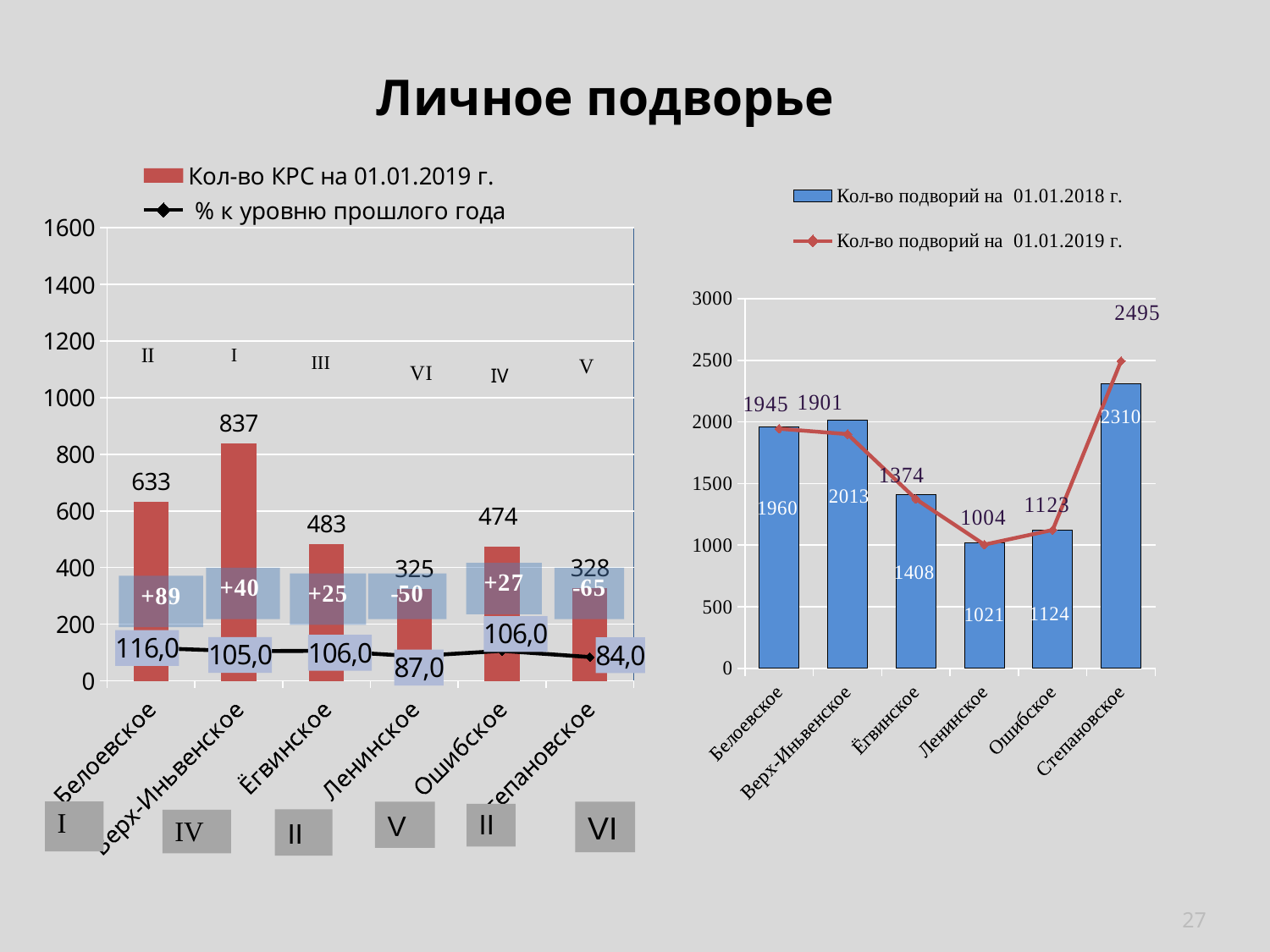
On the left chart, how many series does the legend list? 2 On the left chart, what is the value of Кол-во КРС на 01.01.2019 г. for Верх-Иньвенское? 837 On the left chart, which category has the highest Кол-во КРС на 01.01.2019 г.? Верх-Иньвенское On the right chart, for Верх-Иньвенское, which is larger: Кол-во подворий на 01.01.2018 г. or Кол-во подворий на 01.01.2019 г.? Кол-во подворий на 01.01.2018 г. On the right chart, what is the value of Кол-во подворий на 01.01.2019 г. for Степановское? 2495 On the left chart, what is the difference in Кол-во КРС на 01.01.2019 г. between Белоевское and Ёгвинское? 150 On the left chart, how many categories are shown on the x axis? 6 On the right chart, what is the value of Кол-во подворий на 01.01.2018 г. for Ёгвинское? 1408 On the right chart, what is the difference between Кол-во подворий на 01.01.2019 г. and Кол-во подворий на 01.01.2018 г. for Степановское? 185 On the left chart, which category has the lowest Кол-во КРС на 01.01.2019 г.? Ленинское On the right chart, which category has the lowest Кол-во подворий на 01.01.2018 г.? Ленинское On the left chart, what is the value of % к уровню прошлого года for Ленинское? 87,0